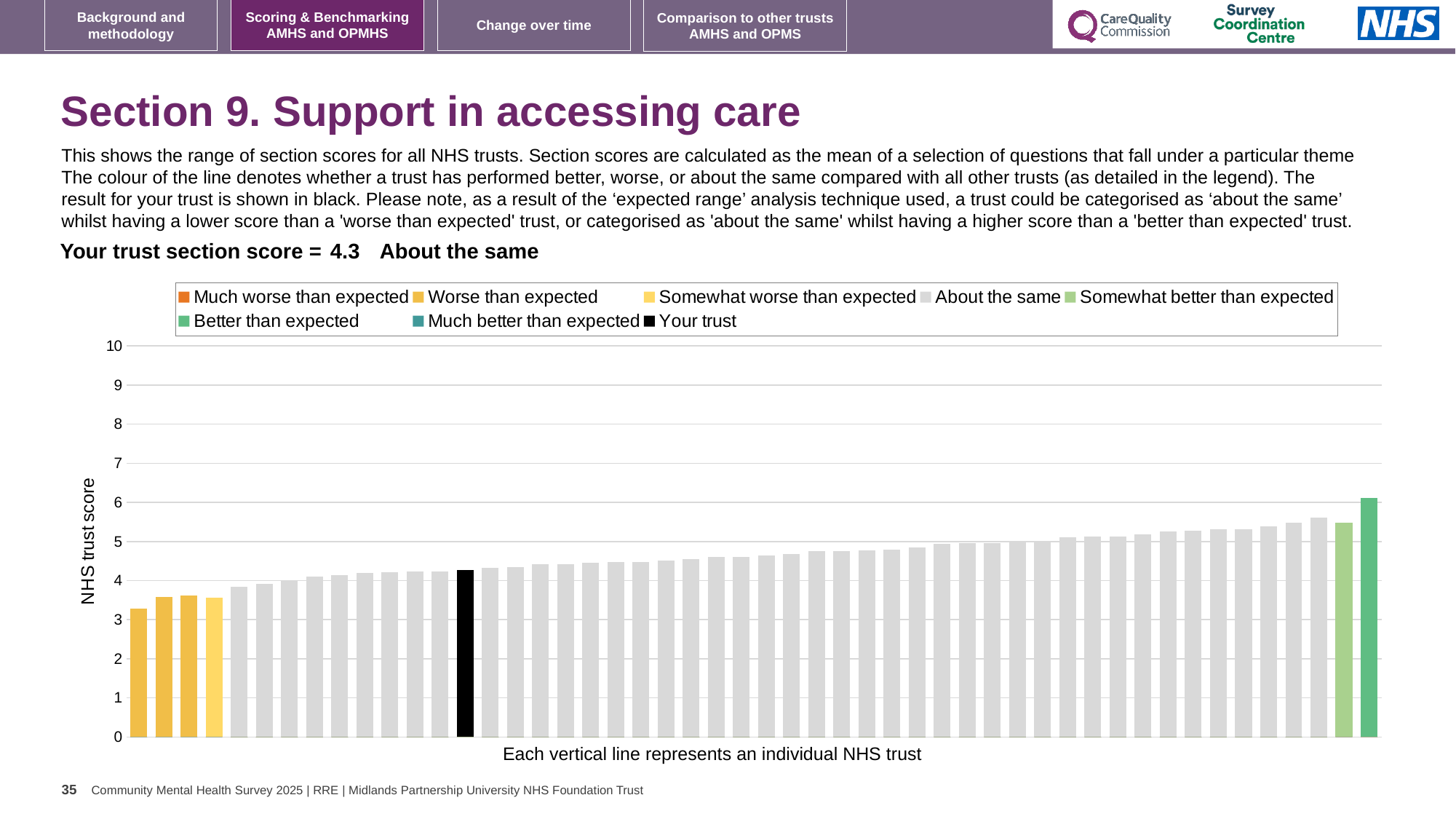
Is the value of the black 'Your trust' bar greater or less than 4? greater Which benchmarking category is your trust placed in for this section? About the same How many bars are coloured in a green shade? 2 Is the value of the tallest bar greater or less than 5? greater Do the bar values rise or fall moving from left to right along the x axis? rise What colour is the bar representing your trust? black Is the value of the leftmost (lowest) bar greater or less than 4? less How many entries does the chart legend list? 8 What is the section score for your trust shown on the slide? 4.3 What kind of chart is shown on the slide? bar chart What is the label on the y axis of the chart? NHS trust score